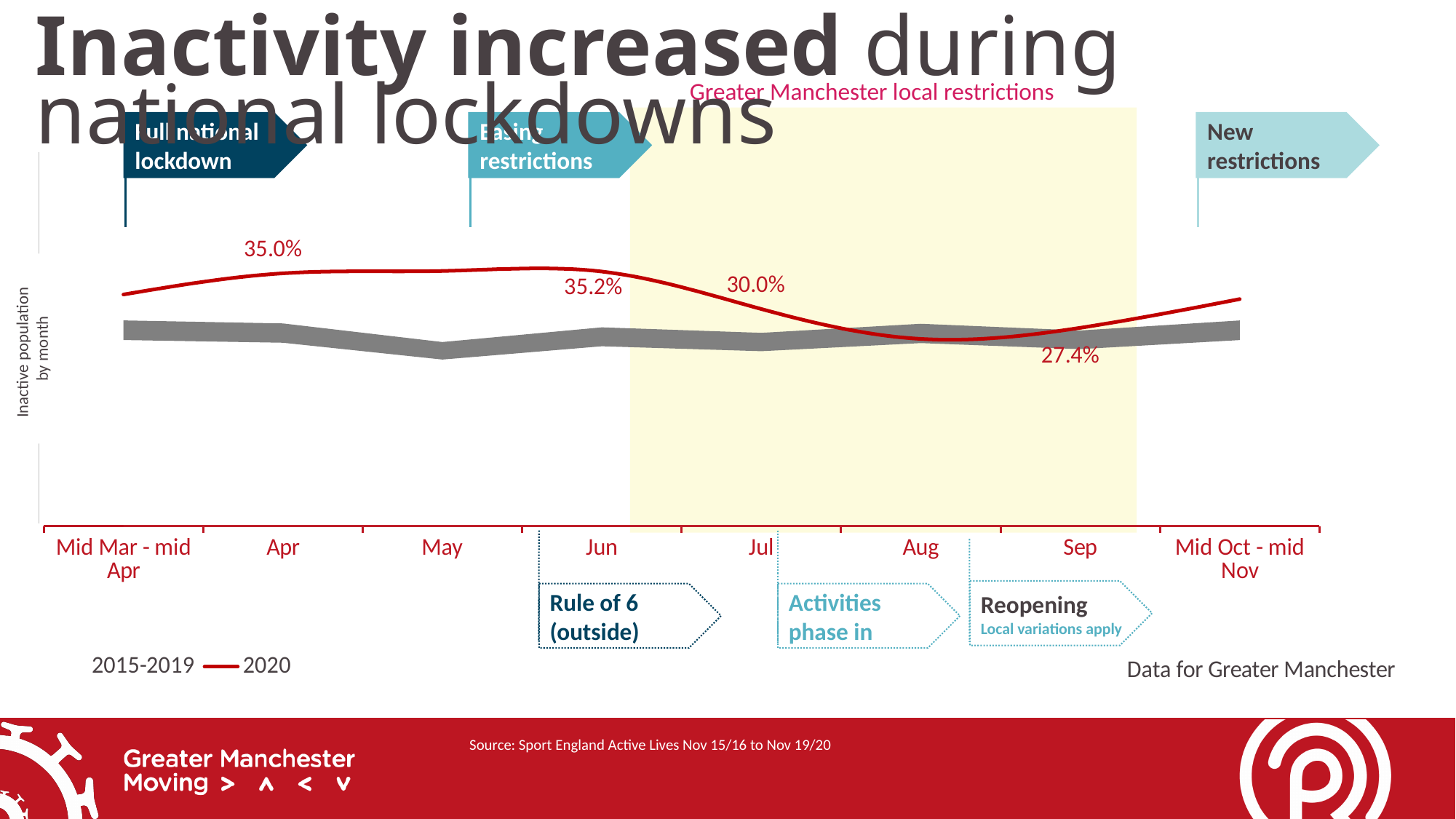
What is the labelled 2020 inactivity value for Apr? 35.0% Does the 2020 line rise or fall between Jun and Sep? Fall What is the labelled 2020 inactivity value for Jun? 35.2% Among the labelled 2020 values, which month has the lowest inactivity? Sep What type of chart is shown on the slide? Line chart How many series does the chart legend list? 2 How many time periods are labelled along the x axis? 8 What is the labelled 2020 inactivity value for Sep? 27.4% What is the difference between the labelled 2020 values for Jun and Sep? 7.8 percentage points What is the labelled 2020 inactivity value for Jul? 30.0% Among the labelled 2020 values, which month has the highest inactivity? Jun What are the two series named in the legend? 2015-2019 and 2020